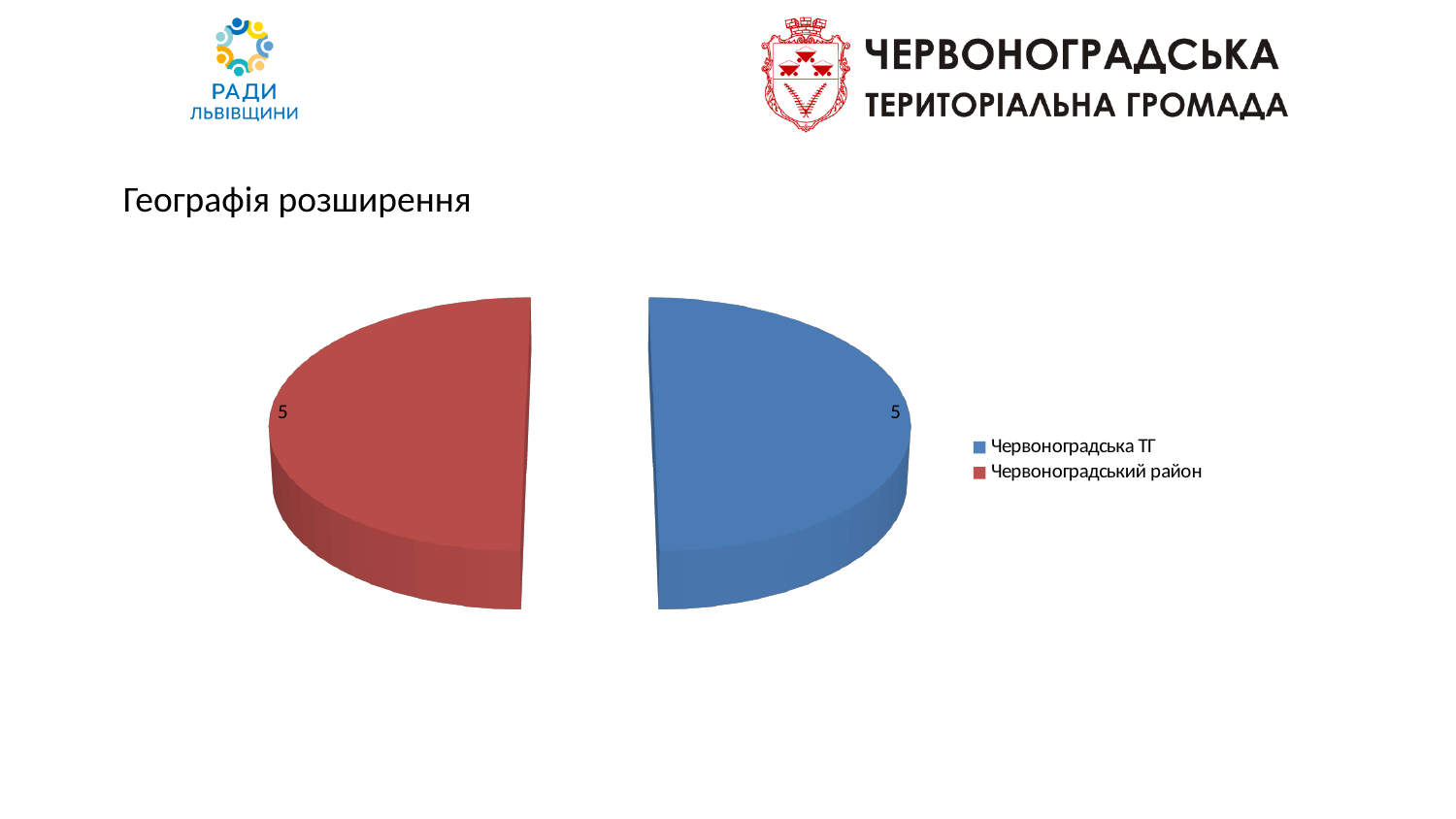
What is the total of the two values shown on the pie chart? 10 What value is shown for the Червоноградська ТГ slice of the pie chart? 5 What value is shown for the Червоноградський район slice of the pie chart? 5 What kind of chart is shown on the slide? Pie chart What is the difference between the values for Червоноградська ТГ and Червоноградський район? 0 What is the heading above the pie chart on the slide? Географія розширення How many slices does the pie chart have? 2 How many entries does the legend of the pie chart list? 2 What share of the pie does the Червоноградська ТГ slice represent? 50% Which colour represents Червоноградський район in the pie chart? Red Is the value for Червоноградська ТГ larger than, smaller than, or equal to the value for Червоноградський район? equal What share of the pie does the Червоноградський район slice represent? 50%